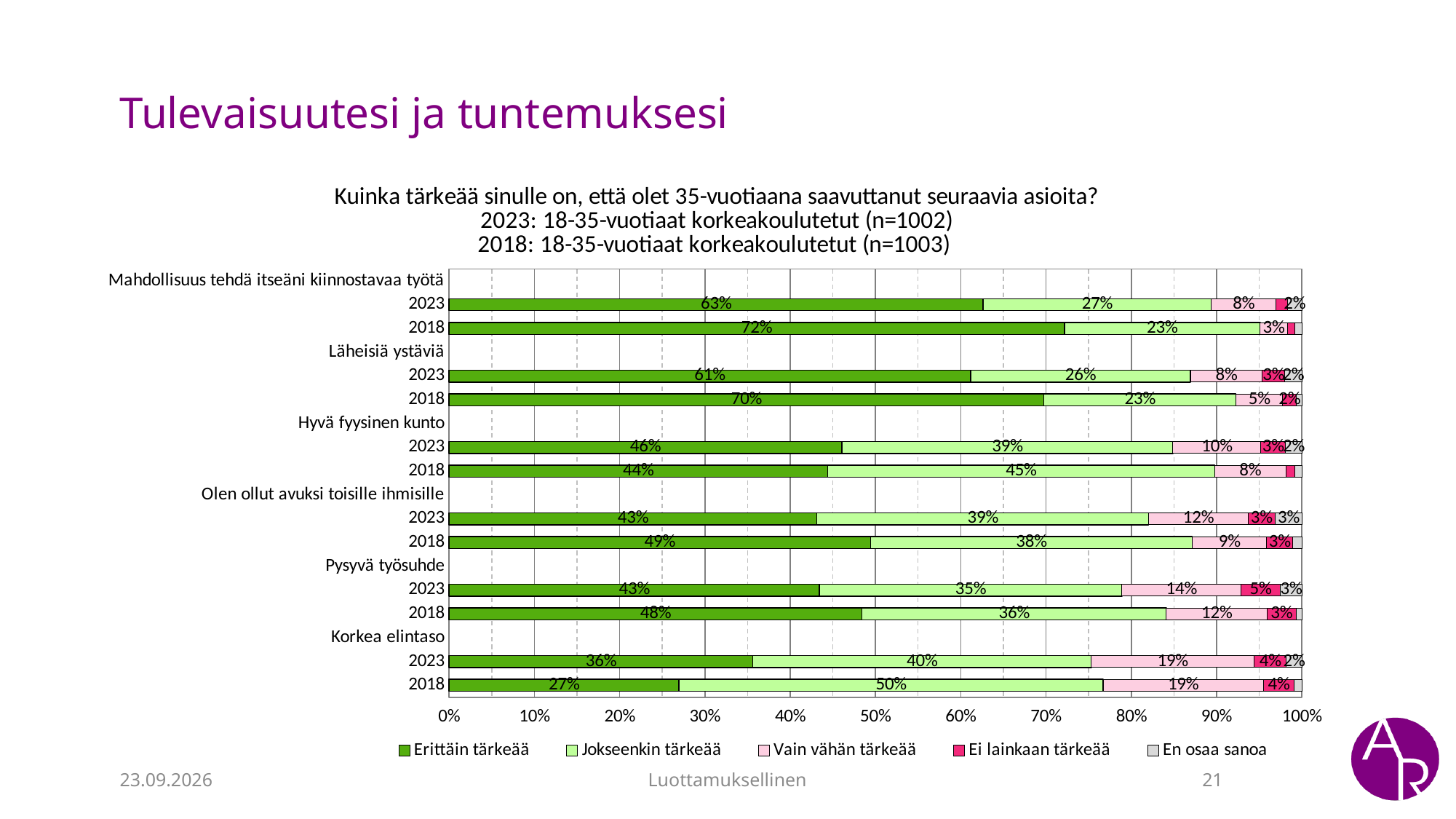
How many series does the legend list? 5 What kind of chart is shown on the slide? stacked bar chart Which bar has the lowest 'Erittäin tärkeää' share? Korkea elintaso, 2018 What is the 'Ei lainkaan tärkeää' share for 'Pysyvä työsuhde' in 2023? 5% What is the 'Erittäin tärkeää' share for 'Mahdollisuus tehdä itseäni kiinnostavaa työtä' in 2023? 63% What is the 'Vain vähän tärkeää' share for 'Pysyvä työsuhde' in 2023? 14% Is the 'Erittäin tärkeää' share for 'Hyvä fyysinen kunto' larger in 2023 or in 2018? 2023 Which legend entry is shown in the darkest green colour? Erittäin tärkeää What is the 'Jokseenkin tärkeää' share for 'Korkea elintaso' in 2018? 50% Which bar has the highest 'Erittäin tärkeää' share? Mahdollisuus tehdä itseäni kiinnostavaa työtä, 2018 By how many percentage points did the 'Erittäin tärkeää' share for 'Läheisiä ystäviä' change from 2018 to 2023? 9 percentage points (70% to 61%) How many topics (statements) are compared in the chart? 6